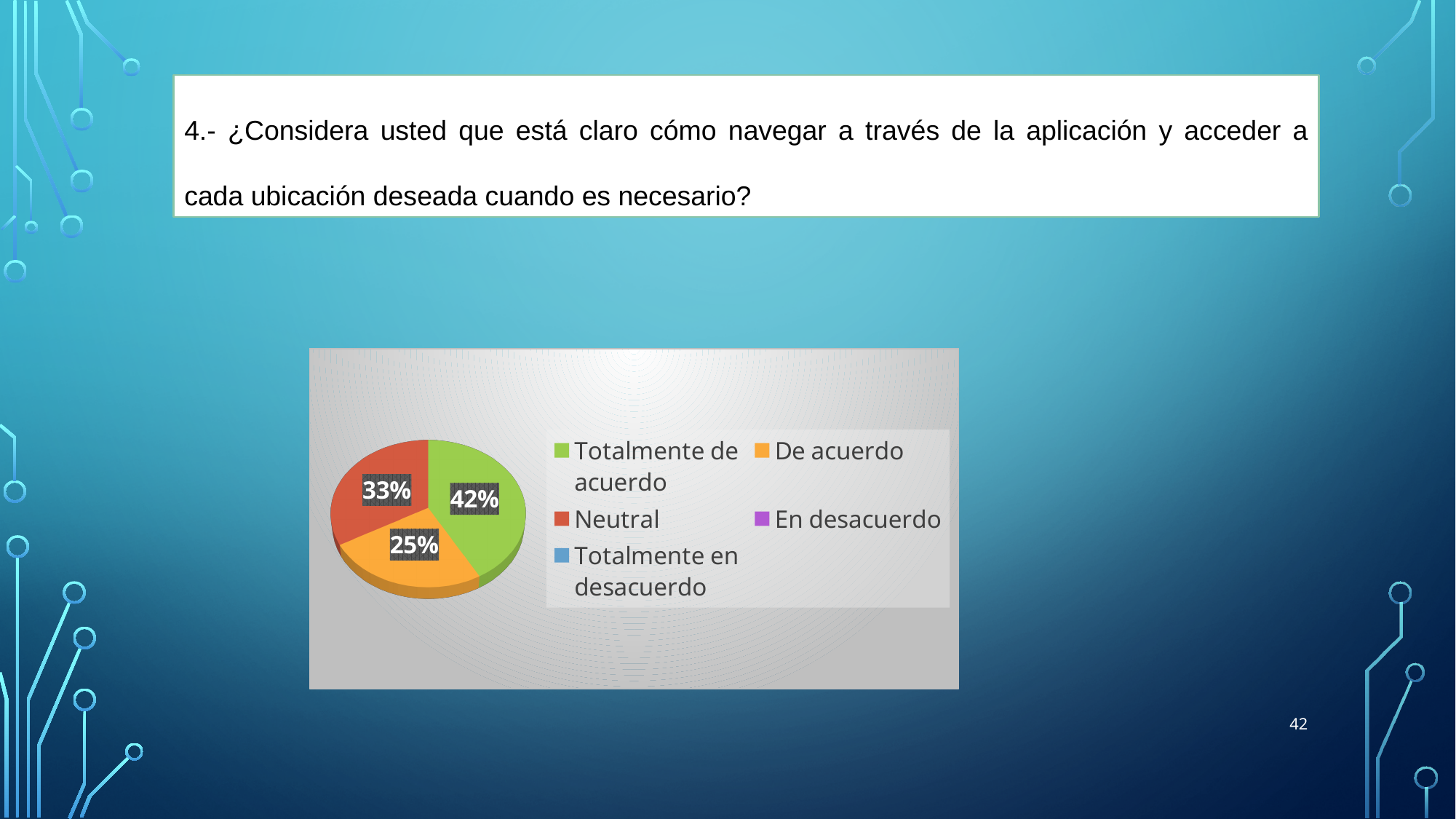
How many slices with printed percentage labels are visible in the pie? 3 How many entries does the legend list? 5 What colour is the "Neutral" slice in the pie chart? Red What is the difference between the "Neutral" and "De acuerdo" shares? 8% What share of the pie does "De acuerdo" represent? 25% Which of the slices with a printed value is the smallest? De acuerdo Which category has the largest slice of the pie? Totalmente de acuerdo What share of the pie does "Totalmente de acuerdo" represent? 42% What share of the pie does "Neutral" represent? 33% What kind of chart is shown on the slide? Pie chart What is the difference between the "Totalmente de acuerdo" and "Neutral" shares? 9% Which is larger, the "Neutral" slice or the "De acuerdo" slice? Neutral